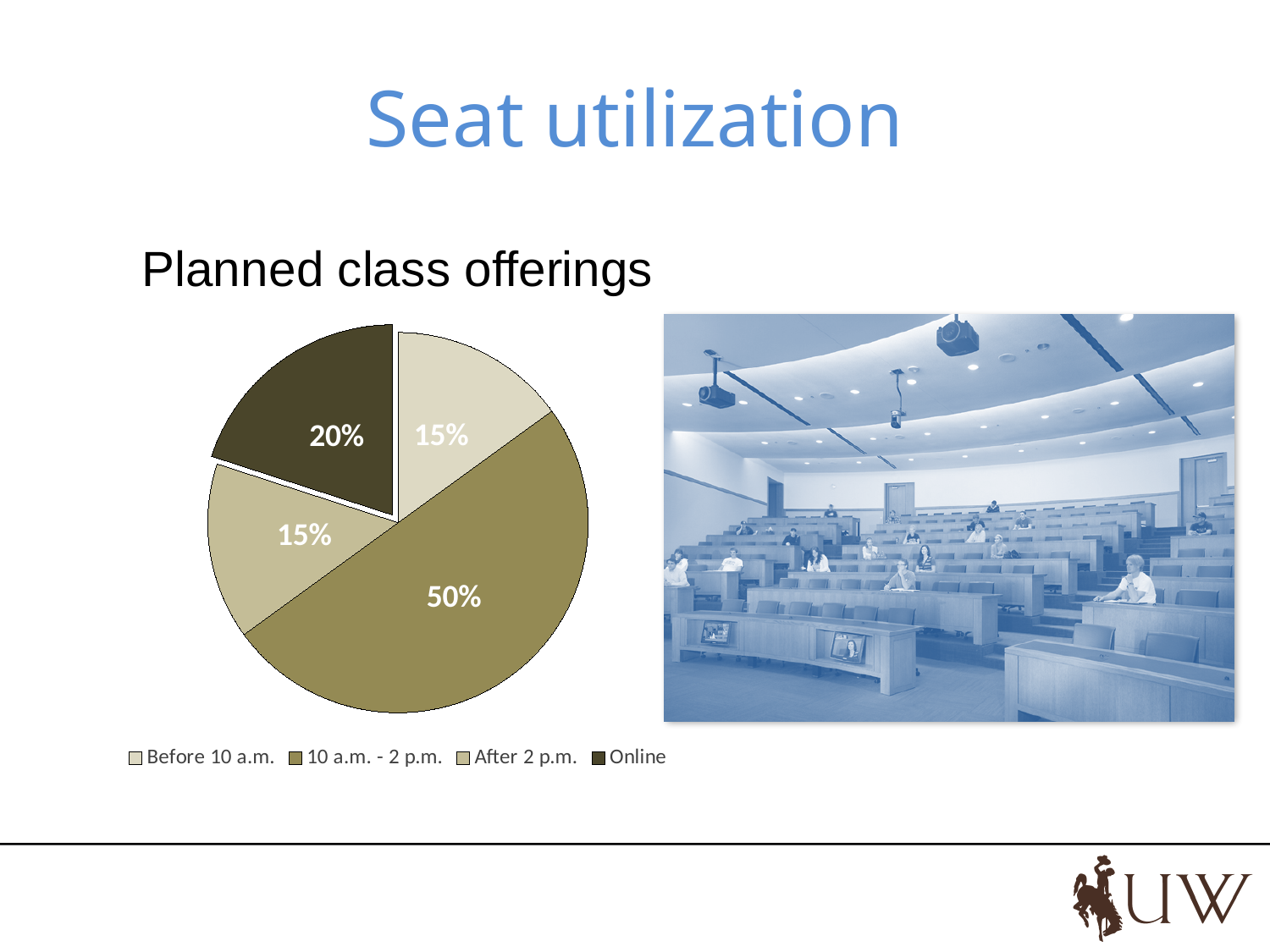
Which is larger, the Online share or the After 2 p.m. share? Online What share of planned class offerings is for 10 a.m. - 2 p.m.? 50% How many slices does the pie chart have? 4 What percentage of planned class offerings is Before 10 a.m.? 15% What is the difference in percentage points between the 10 a.m. - 2 p.m. slice and the Online slice? 30 Which category has the largest share of planned class offerings? 10 a.m. - 2 p.m. What percentage of planned class offerings is Online? 20% What type of chart is shown on the slide? Pie chart Which slice is pulled out from the rest of the pie? Online What percentage of planned class offerings is After 2 p.m.? 15% What is the title of the chart? Planned class offerings How many entries does the legend list? 4